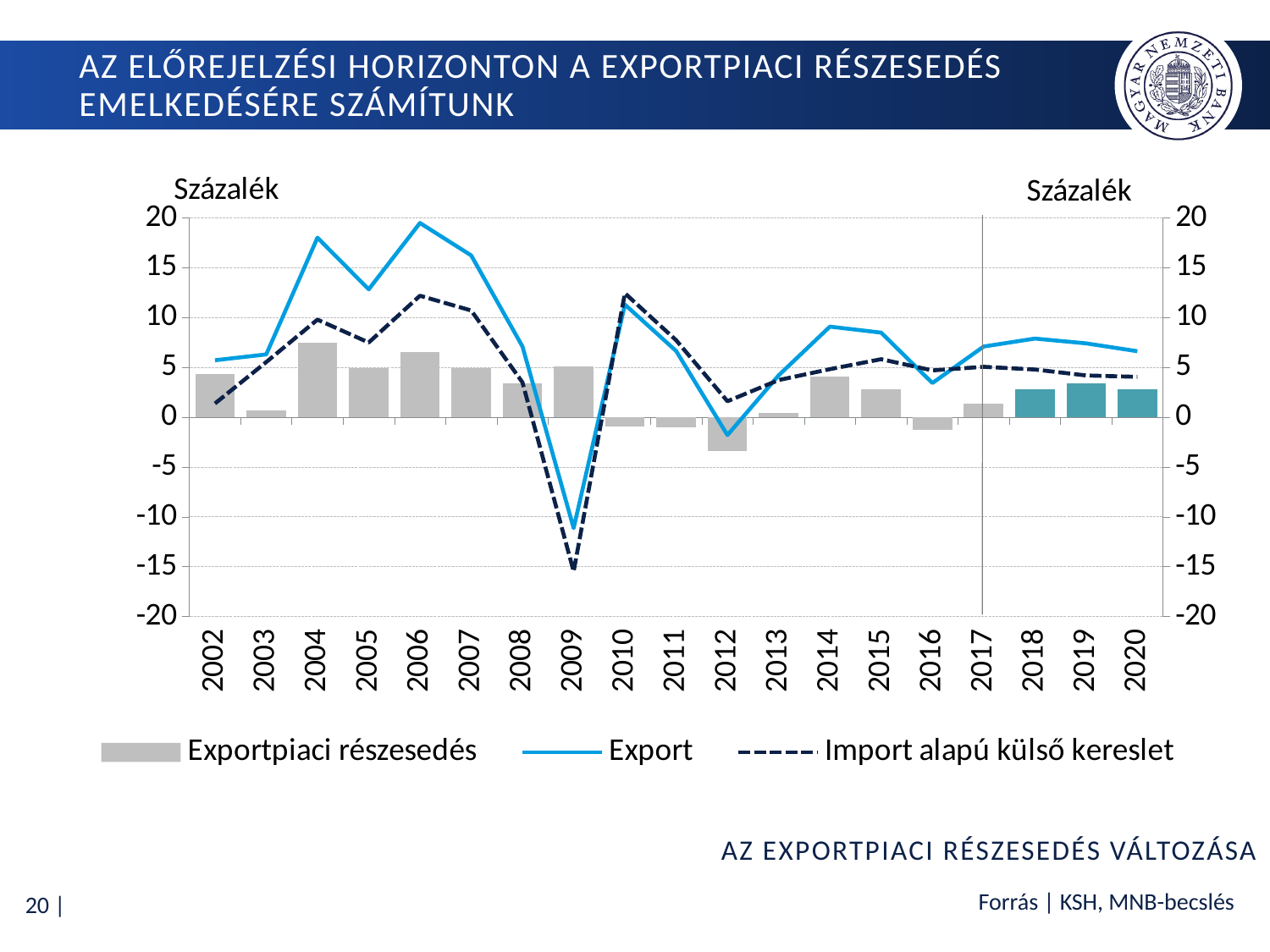
What type of chart is shown on the slide? Combined bar and line chart Which is larger, the Export value in 2004 or in 2005? 2004 In which year does the Export line reach its highest value? 2006 How many series does the legend list? 3 In which year is the Exportpiaci részesedés bar the highest? 2004 In which year does the Export line reach its lowest value? 2009 Is the Exportpiaci részesedés value for 2004 greater or less than 5? greater How many years are shown on the x axis? 19 What unit label is shown on the vertical axes? Százalék Is the Export value for 2006 greater or less than 15? greater Is the Import alapú külső kereslet value for 2009 greater or less than -10? less In which year is the Exportpiaci részesedés bar the lowest? 2012